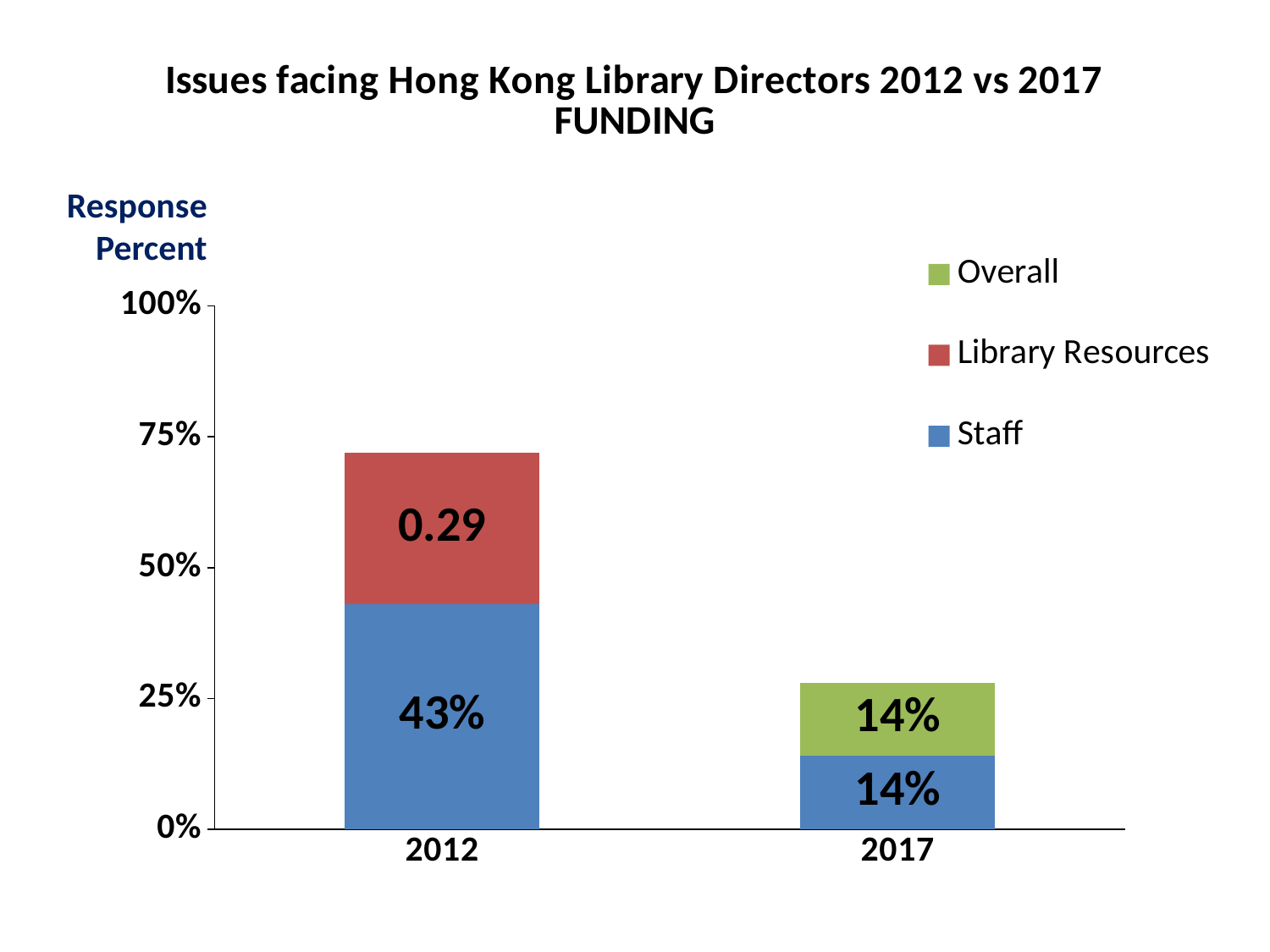
Is the total height of the 2012 bar greater or less than 50%? greater Is the total height of the 2017 bar greater or less than 50%? less How many series does the legend list? 3 What is the total of the stacked bar for 2017? 28% What is the value for Staff in 2017? 14% By how much did the Staff value fall from 2012 to 2017? 29% Which year has the larger Staff value, 2012 or 2017? 2012 What is the value for Staff in 2012? 43% How many years are shown on the x axis? 2 What is the value for Overall in 2017? 14% What is the value labelled on the Library Resources segment for 2012? 0.29 What kind of chart is shown on the slide? Stacked bar chart